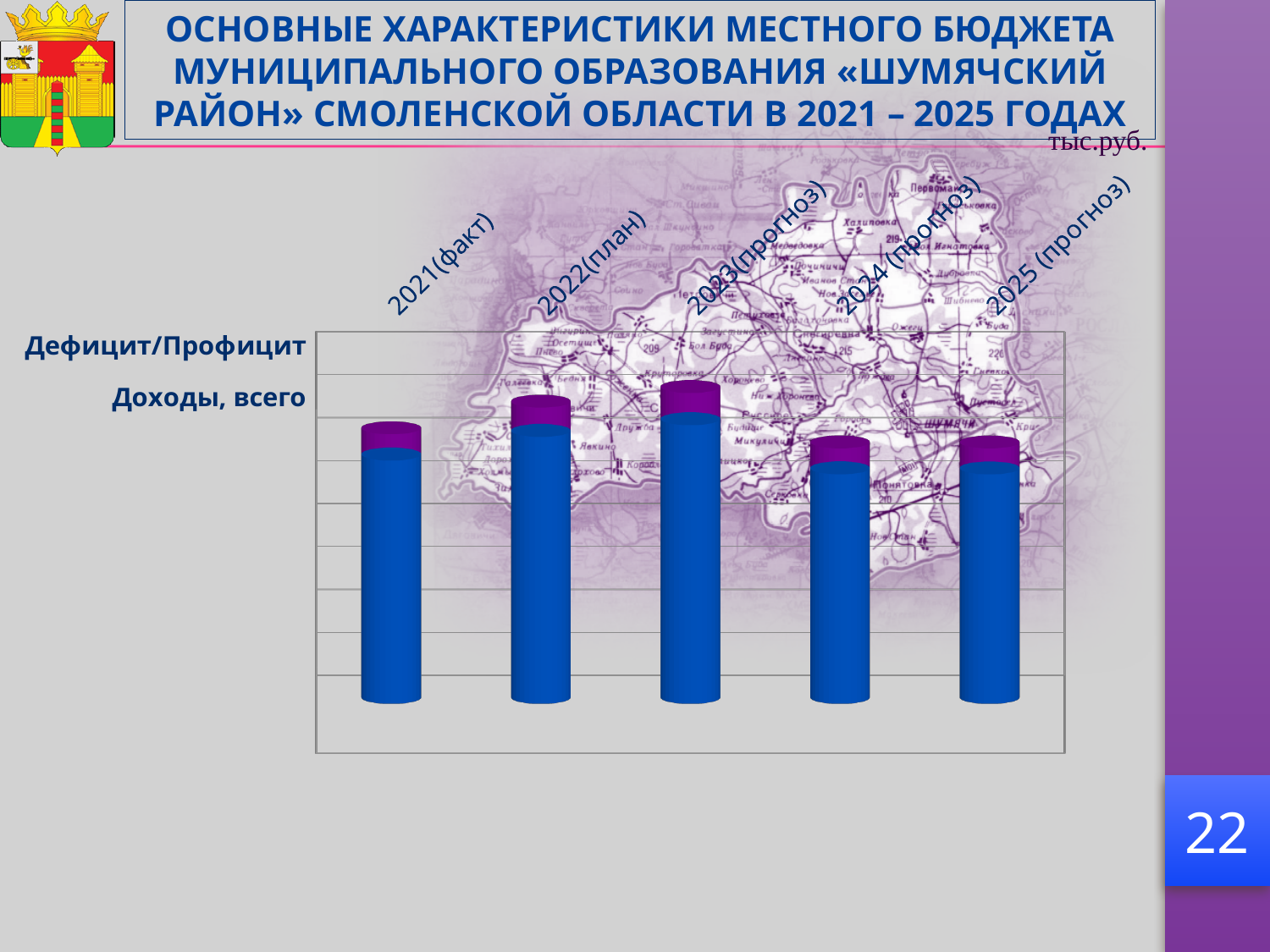
Is the Доходы, всего bar taller for 2021(факт) or for 2024 (прогноз)? 2021(факт) What kind of chart is shown on the slide? bar chart How many year categories are plotted along the x axis? 5 Which series is shown in blue in the chart? Доходы, всего What unit of measurement is indicated for the chart values? тыс.руб. Do the Доходы, всего bars rise or fall from 2021(факт) to 2023(прогноз)? rise Is the Доходы, всего bar taller for 2023(прогноз) or for 2021(факт)? 2023(прогноз) Is the Доходы, всего bar taller for 2022(план) or for 2024 (прогноз)? 2022(план) Which year has the tallest bar for Доходы, всего? 2023(прогноз) Do the Доходы, всего bars rise or fall from 2023(прогноз) to 2024 (прогноз)? fall